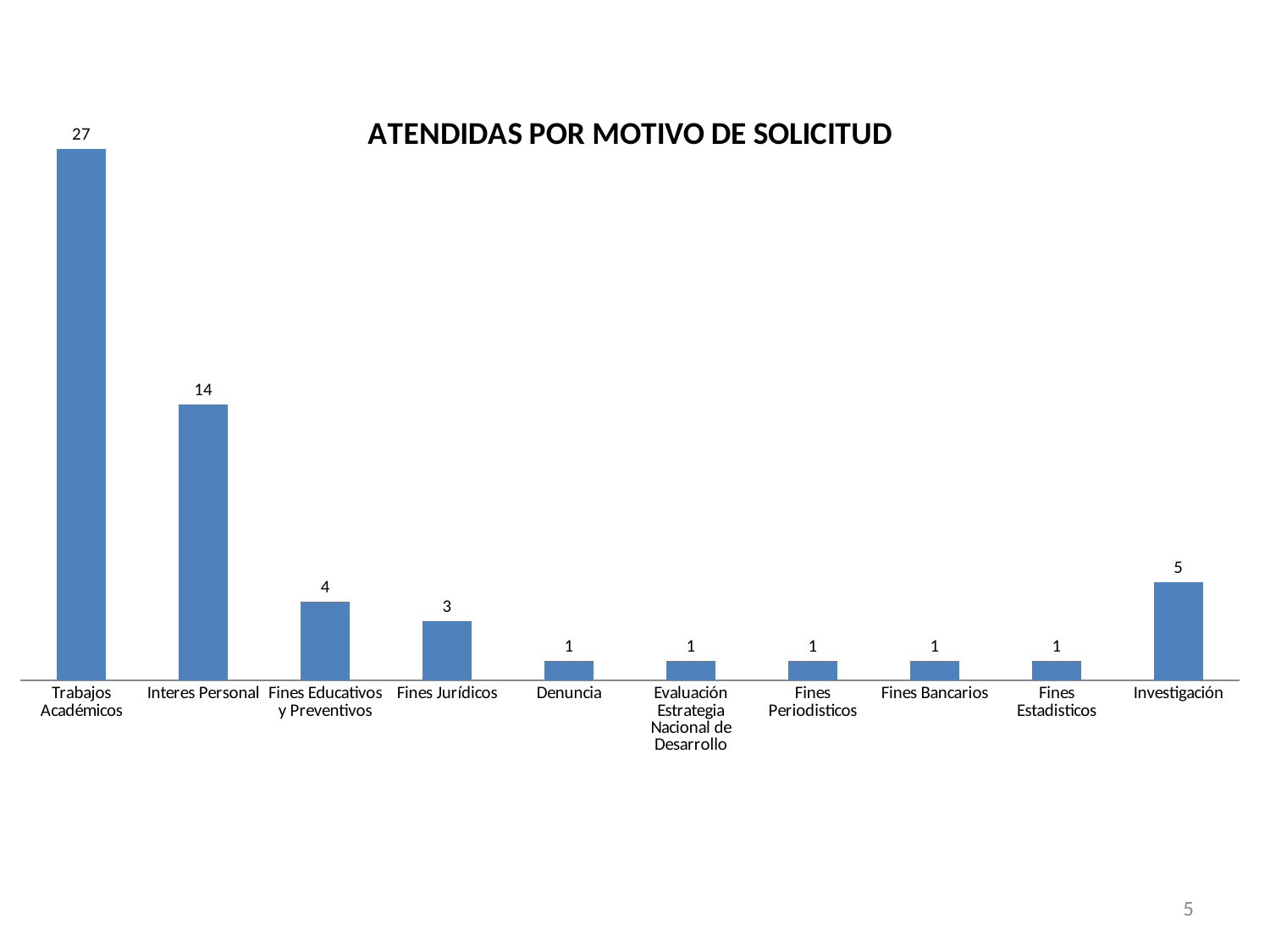
How many categories have a value of 1? 5 What kind of chart is shown? Bar chart What is the difference between Investigación and Fines Educativos y Preventivos? 1 What is the difference between Trabajos Académicos and Interes Personal? 13 What is the title of the chart? ATENDIDAS POR MOTIVO DE SOLICITUD What is the value for Trabajos Académicos? 27 What is the value for Fines Jurídicos? 3 How many categories are shown on the x axis? 10 What is the value for Interes Personal? 14 What is the value for Investigación? 5 Which is larger, Fines Jurídicos or Investigación? Investigación Which category has the highest value? Trabajos Académicos